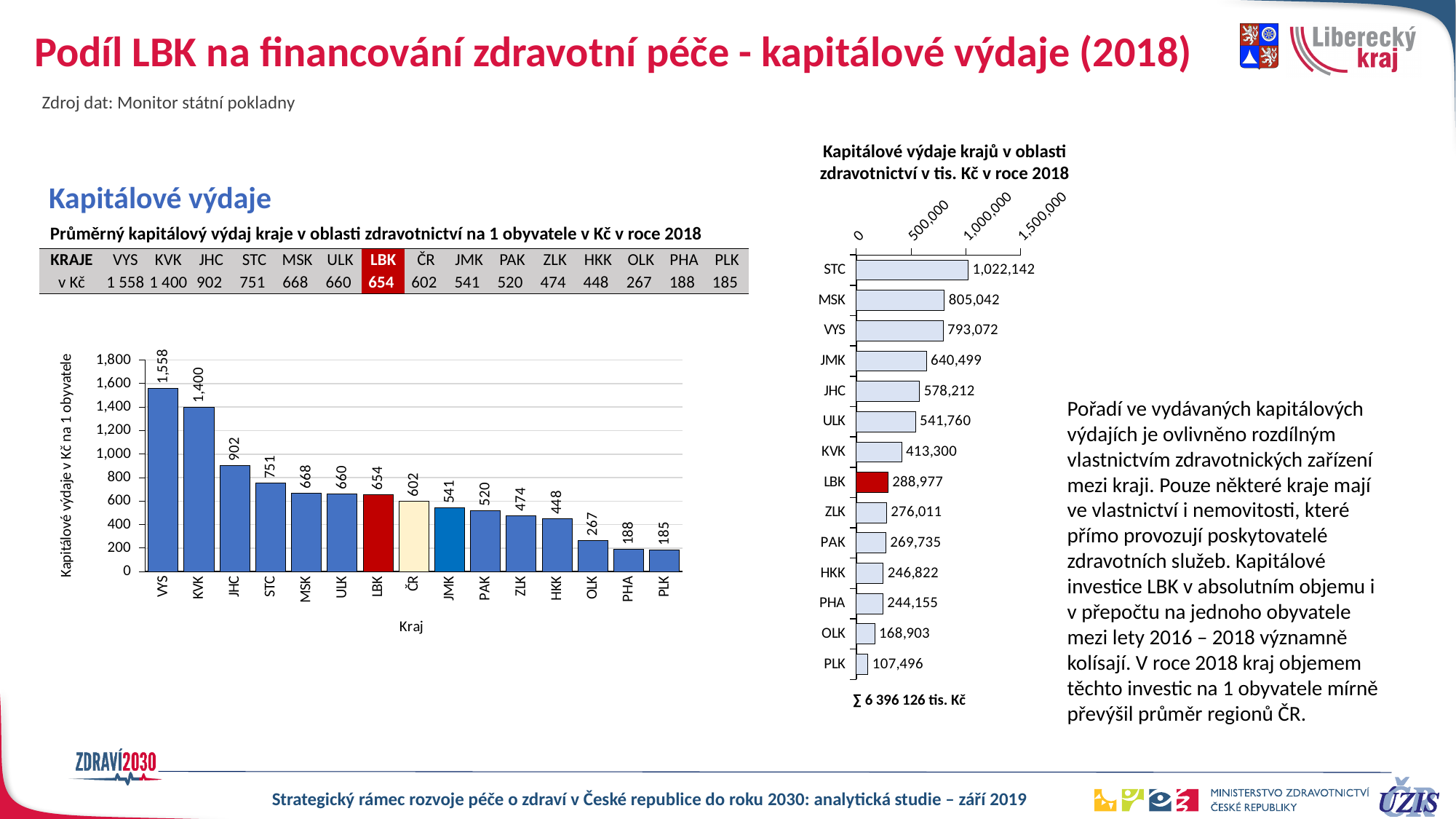
In the left chart (Průměrný kapitálový výdaj kraje na 1 obyvatele), how many categories are shown on the x axis? 15 In the right chart (Kapitálové výdaje krajů v oblasti zdravotnictví v tis. Kč), which category has the highest value? STC In the left chart (Průměrný kapitálový výdaj kraje na 1 obyvatele), which category has the lowest value? PLK In the right chart (Kapitálové výdaje krajů v oblasti zdravotnictví v tis. Kč), which is larger, the value for MSK or the value for VYS? MSK In the right chart (Kapitálové výdaje krajů v oblasti zdravotnictví v tis. Kč), what is the value for LBK? 288,977 In the left chart (Průměrný kapitálový výdaj kraje na 1 obyvatele), which category has the highest value? VYS In the left chart (Průměrný kapitálový výdaj kraje na 1 obyvatele), what is the value for LBK? 654 In the left chart (Průměrný kapitálový výdaj kraje na 1 obyvatele), do the values rise or fall from left to right along the x axis? fall In the right chart (Kapitálové výdaje krajů v oblasti zdravotnictví v tis. Kč), what is the difference between the values for STC and PLK? 914,646 What kind of chart is the right chart (Kapitálové výdaje krajů v oblasti zdravotnictví v tis. Kč)? bar chart In the right chart (Kapitálové výdaje krajů v oblasti zdravotnictví v tis. Kč), how many categories are shown? 14 In the left chart (Průměrný kapitálový výdaj kraje na 1 obyvatele), what is the difference between the values for LBK and ČR? 52